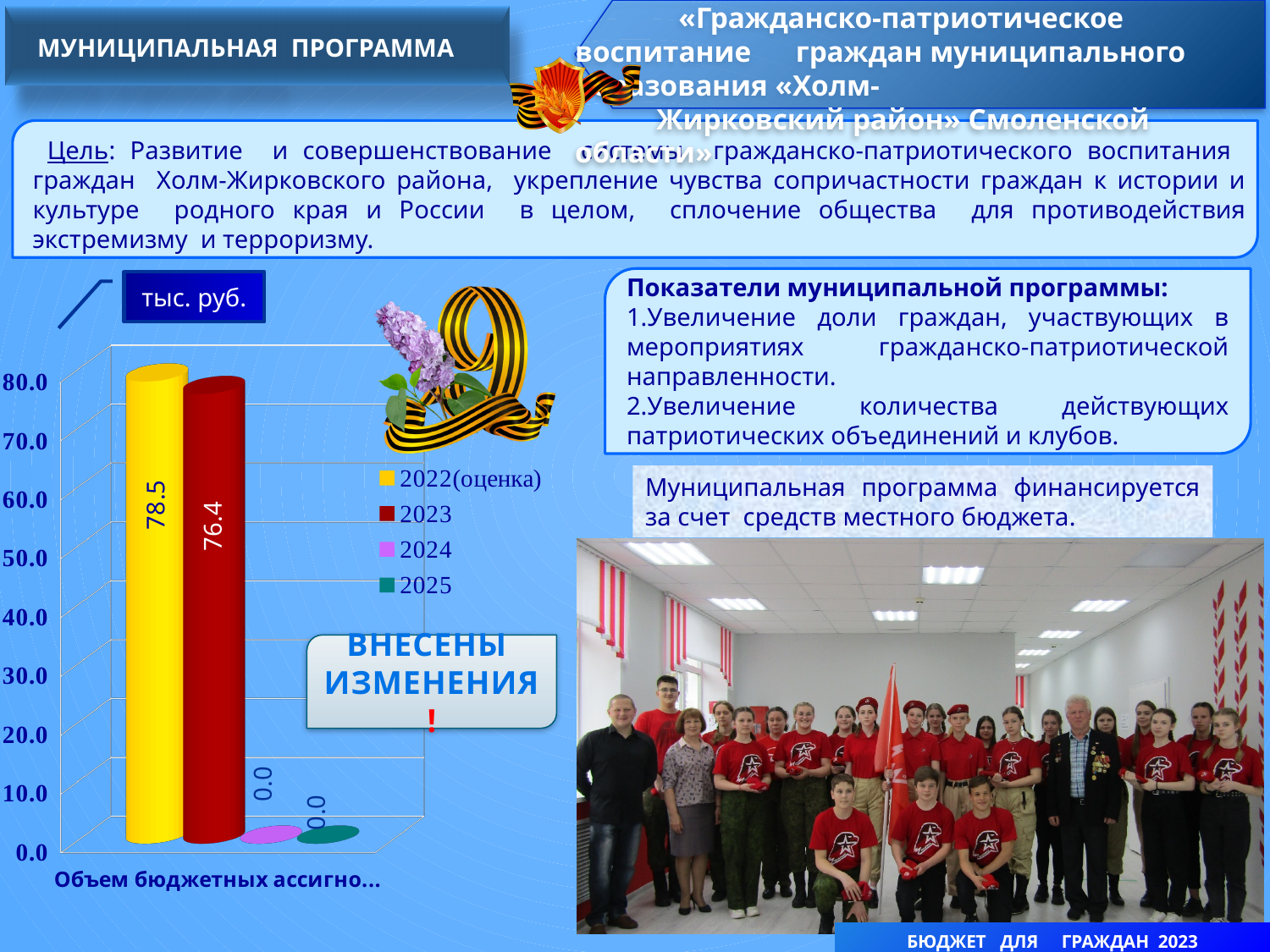
How many series does the chart legend list? 4 Which is larger, the value for 2022(оценка) or the value for 2023? 2022(оценка) What is the value for 2022(оценка) in the chart? 78.5 Is the value for 2023 greater or less than 70.0? greater What is the value for 2023 in the chart? 76.4 What unit of measurement is shown above the chart? тыс. руб. What is the value for 2025 in the chart? 0.0 What is the difference between the values for 2022(оценка) and 2023? 2.1 What colour is the bar for 2023 in the chart? dark red What is the value for 2024 in the chart? 0.0 Which series has the highest value in the chart? 2022(оценка) What kind of chart is shown on the slide? bar chart